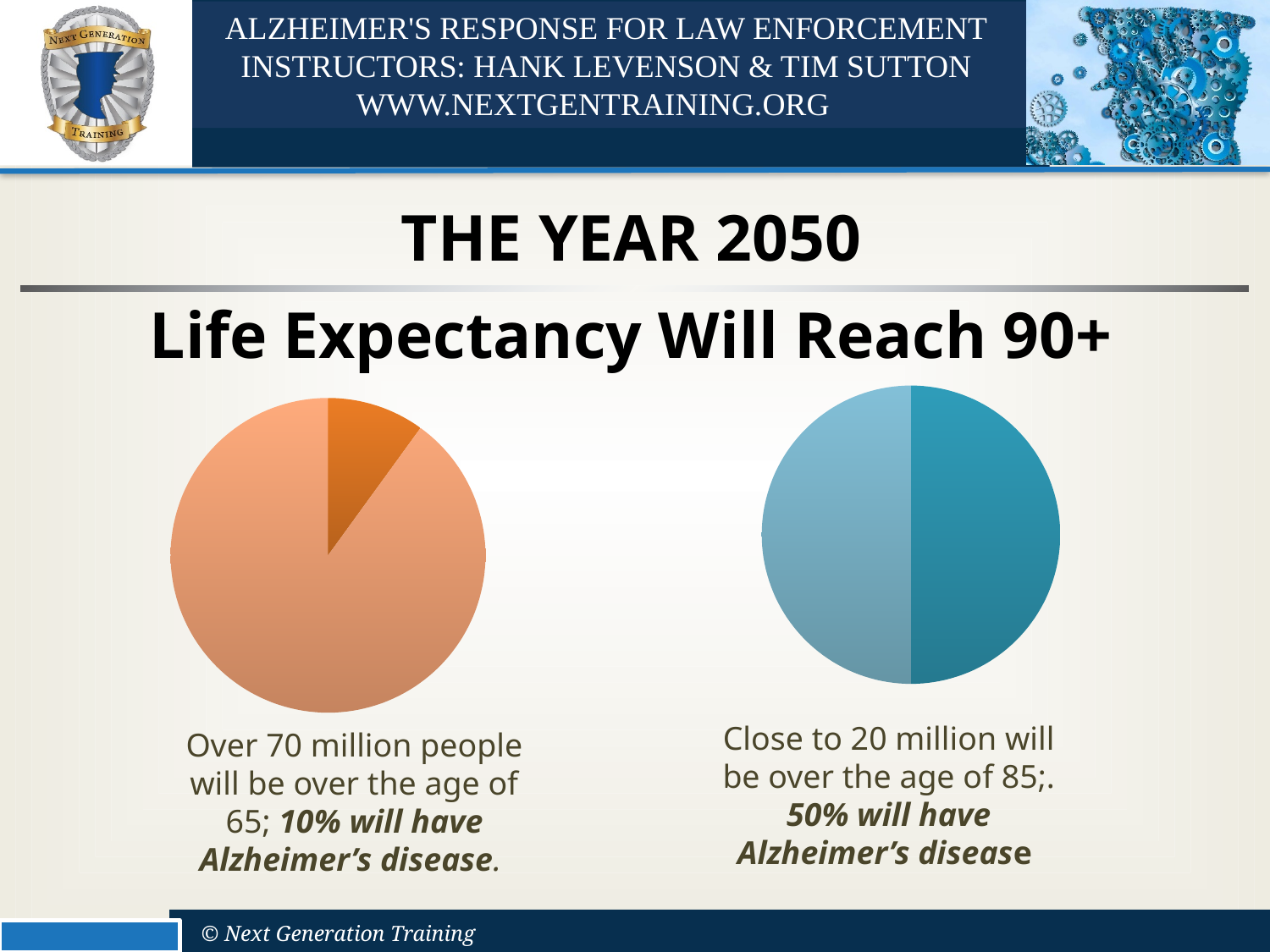
What is the heading printed directly above the two pie charts? Life Expectancy Will Reach 90+ In the left pie chart, is the dark orange slice larger or smaller than the light orange slice? smaller How many slices does the left pie chart have? 2 Is the share with Alzheimer's disease shown in the left pie chart greater or less than 50%? less What colour scheme is used for the right pie chart? blue How many charts are shown on the slide? 2 According to the caption under the left pie chart, what share of people over 65 will have Alzheimer's disease? 10% What kind of chart is the left chart on the slide? pie chart Which pie chart shows the larger share with Alzheimer's disease, the left (over 65) or the right (over 85)? right (over 85) According to the caption under the right pie chart, what share of people over 85 will have Alzheimer's disease? 50% How many slices does the right pie chart have? 2 What kind of chart is the right chart on the slide? pie chart